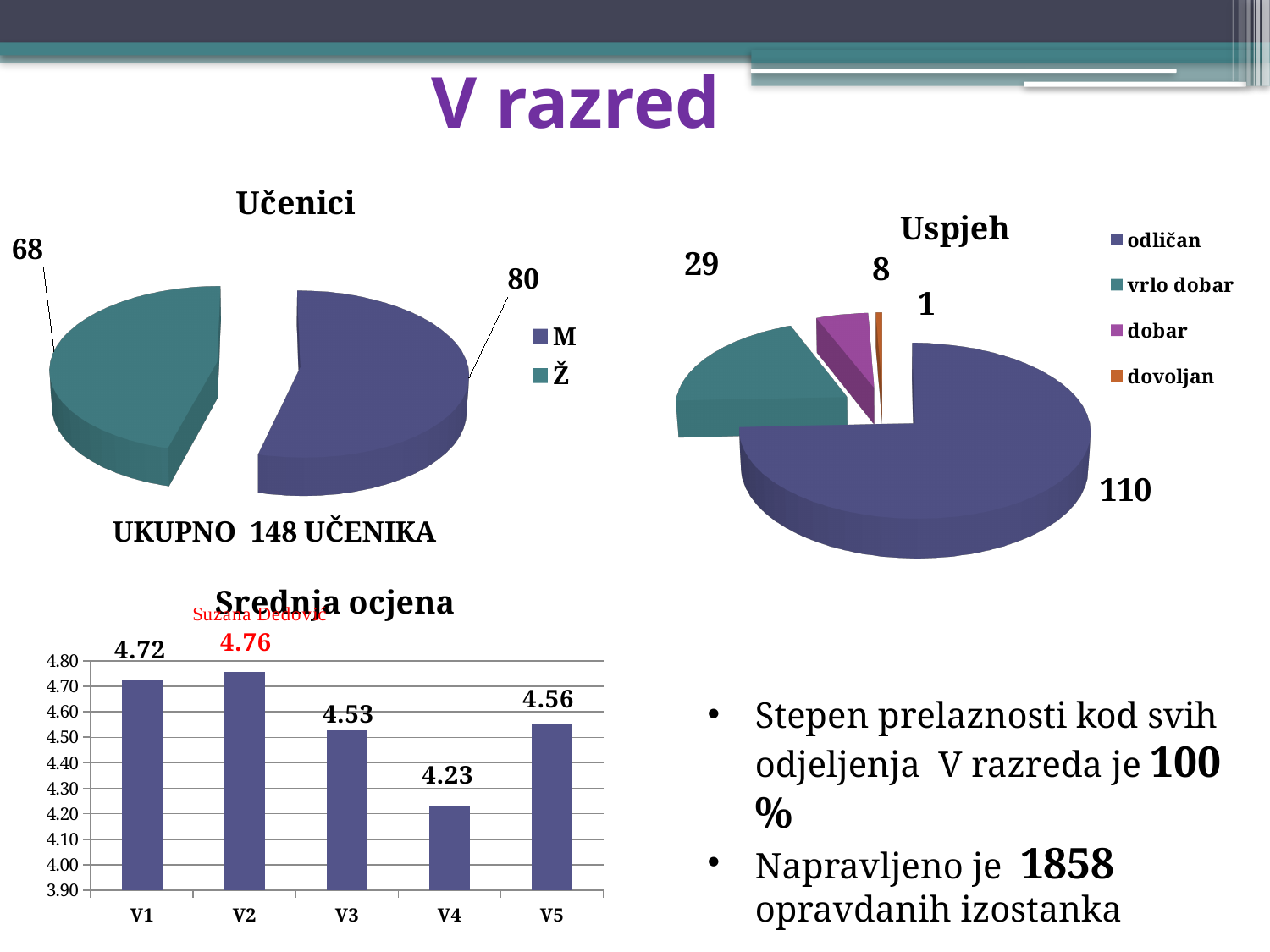
What kind of chart is 'Srednja ocjena'? bar chart In the 'Uspjeh' pie chart, what is the value for vrlo dobar? 29 In the 'Srednja ocjena' bar chart, which category has the highest value? V2 In the 'Uspjeh' pie chart, what is the value for odličan? 110 How many categories does the legend of the 'Uspjeh' pie chart list? 4 In the 'Uspjeh' pie chart, which category has the smallest value? dovoljan In the 'Učenici' pie chart, what is the difference between the M and Ž values? 12 How many categories are shown in the 'Srednja ocjena' bar chart? 5 In the 'Srednja ocjena' bar chart, what is the value for V4? 4.23 In the 'Učenici' pie chart, what is the value for M? 80 In the 'Učenici' pie chart, what is the value for Ž? 68 In the 'Srednja ocjena' bar chart, which is larger, V3 or V5? V5